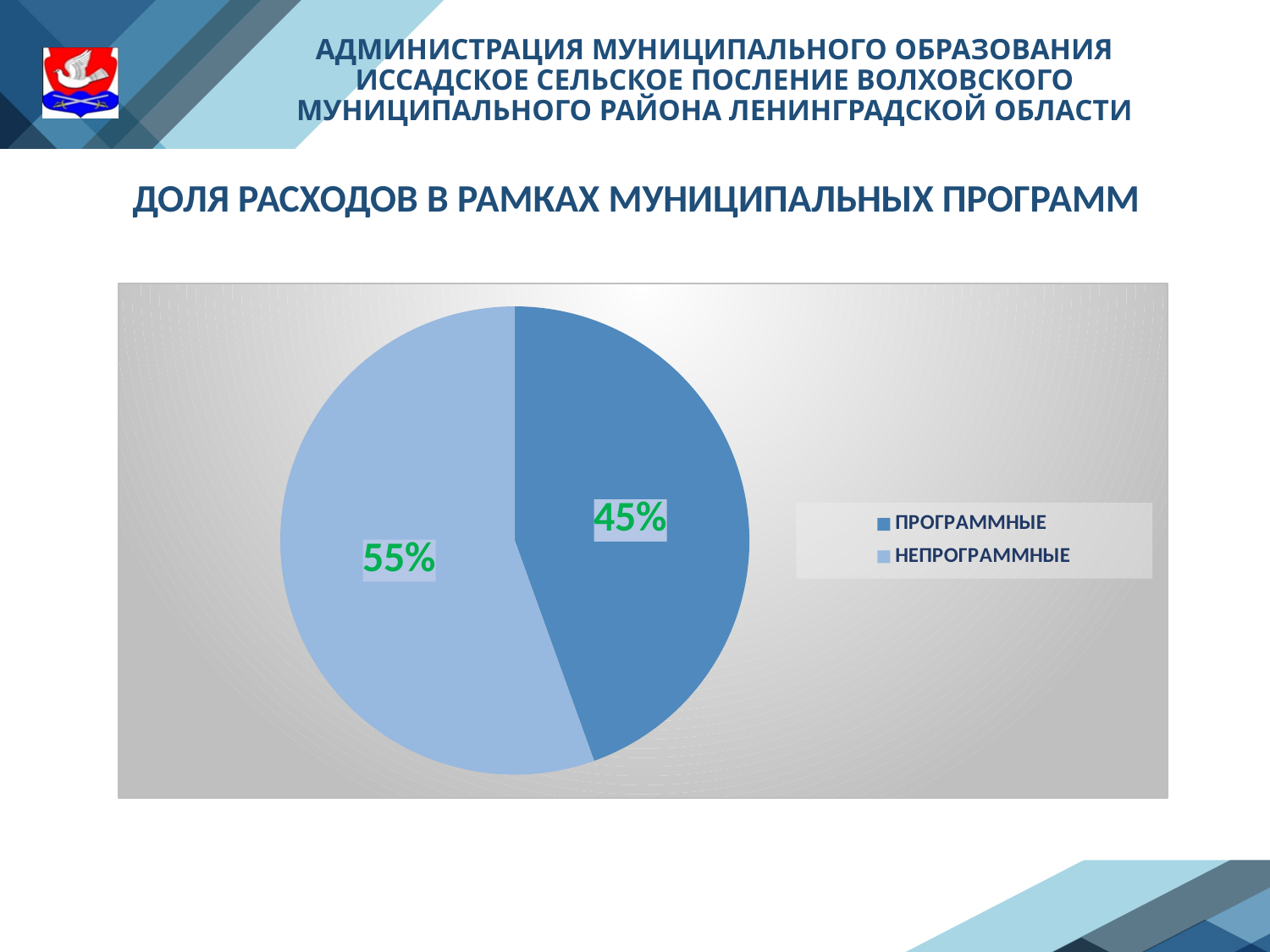
What share of the pie is labelled ПРОГРАММНЫЕ? 45% Which is larger, the ПРОГРАММНЫЕ slice or the НЕПРОГРАММНЫЕ slice? НЕПРОГРАММНЫЕ How many slices does the pie chart have? 2 Is the share for ПРОГРАММНЫЕ greater or less than 50%? less What is the title of the chart? ДОЛЯ РАСХОДОВ В РАМКАХ МУНИЦИПАЛЬНЫХ ПРОГРАММ Which slice is the largest? НЕПРОГРАММНЫЕ What share of the pie is labelled НЕПРОГРАММНЫЕ? 55% Which legend entry is shown in the darker blue colour? ПРОГРАММНЫЕ What type of chart is shown on the slide? Pie chart Which slice is the smallest? ПРОГРАММНЫЕ What is the difference in percentage points between the НЕПРОГРАММНЫЕ and ПРОГРАММНЫЕ slices? 10% How many entries does the legend list? 2